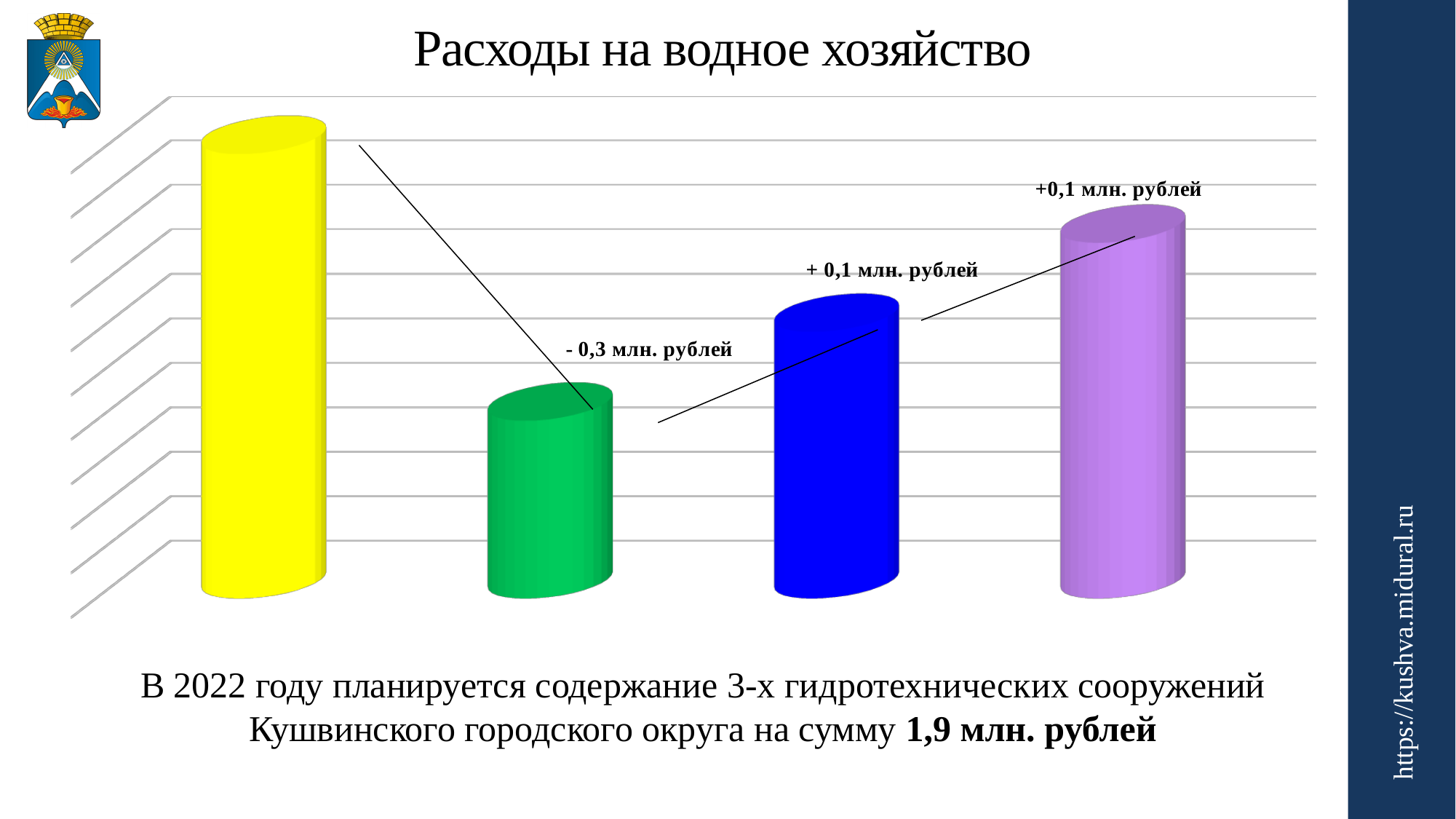
Which bar is the tallest in the chart? the yellow (first) bar How many bars are plotted in the chart? 4 Which bar is the shortest in the chart? the green (second) bar What colour is the third bar in the chart? blue What is the title of the chart? Расходы на водное хозяйство Which is taller, the yellow bar or the green bar? the yellow bar What change is labelled between the second (green) bar and the third (blue) bar? + 0,1 млн. рублей Do the values rise or fall from the second bar to the fourth bar? rise What kind of chart is shown on the slide? bar chart Which is taller, the blue bar or the purple bar? the purple bar What change is labelled between the third (blue) bar and the fourth (purple) bar? +0,1 млн. рублей What change is labelled between the first (yellow) bar and the second (green) bar? - 0,3 млн. рублей